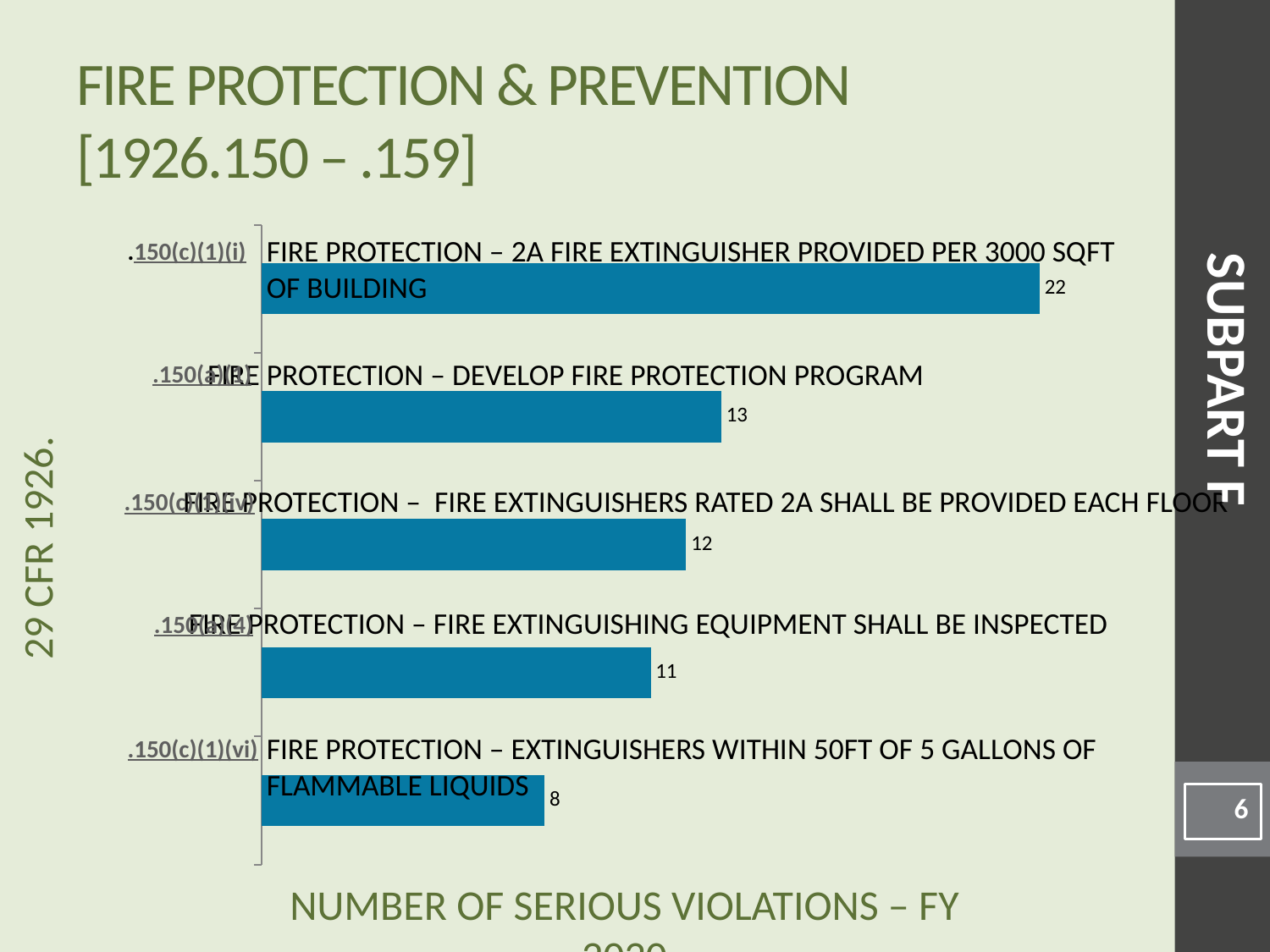
Which has more serious violations: "DEVELOP FIRE PROTECTION PROGRAM" or "FIRE EXTINGUISHING EQUIPMENT SHALL BE INSPECTED"? DEVELOP FIRE PROTECTION PROGRAM Which category has the highest number of serious violations? FIRE PROTECTION – 2A FIRE EXTINGUISHER PROVIDED PER 3000 SQFT OF BUILDING What is the difference between the highest value (22) and the lowest value (8) in the chart? 14 How many categories (bars) are shown in the chart? 5 What type of chart is shown on the slide? Bar chart What is the value for "FIRE PROTECTION – FIRE EXTINGUISHERS RATED 2A SHALL BE PROVIDED EACH FLOOR"? 12 What is the value for "FIRE PROTECTION – FIRE EXTINGUISHING EQUIPMENT SHALL BE INSPECTED"? 11 Which category has the lowest number of serious violations? FIRE PROTECTION – EXTINGUISHERS WITHIN 50FT OF 5 GALLONS OF FLAMMABLE LIQUIDS How many serious violations are shown for "FIRE PROTECTION – 2A FIRE EXTINGUISHER PROVIDED PER 3000 SQFT OF BUILDING"? 22 What is the value for "FIRE PROTECTION – DEVELOP FIRE PROTECTION PROGRAM"? 13 What is the value for "FIRE PROTECTION – EXTINGUISHERS WITHIN 50FT OF 5 GALLONS OF FLAMMABLE LIQUIDS"? 8 What is the difference in serious violations between "2A FIRE EXTINGUISHER PROVIDED PER 3000 SQFT OF BUILDING" and "DEVELOP FIRE PROTECTION PROGRAM"? 9